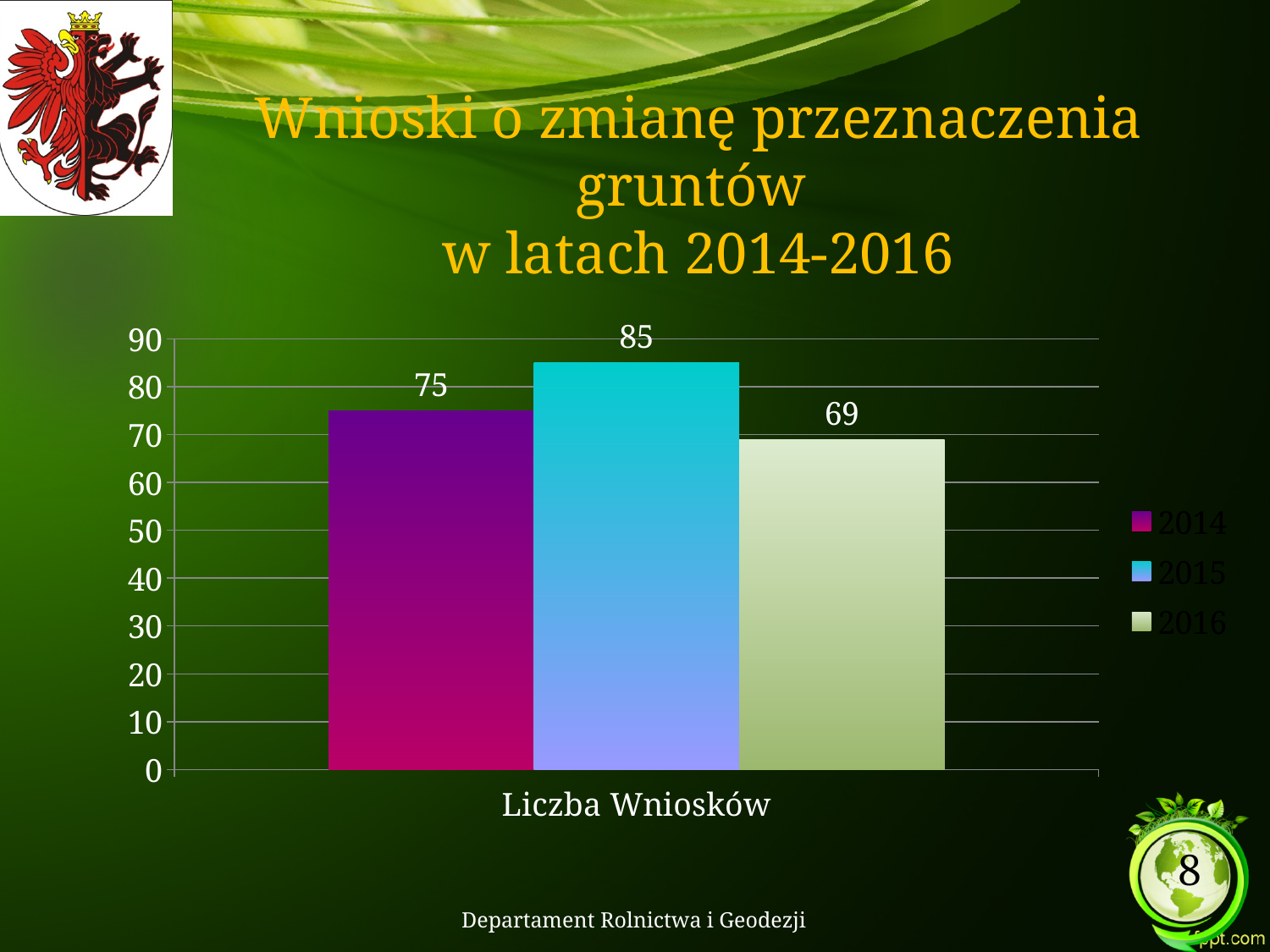
What is the difference between the values for 2014 and 2016? 6 Is the value for 2015 greater or less than 80? greater What is the value for 2015? 85 Which year has the lowest value? 2016 How many series does the legend list? 3 What is the difference between the values for 2015 and 2014? 10 Which year has the highest value? 2015 What is the label shown below the bars on the x axis? Liczba Wniosków What kind of chart is shown on the slide? bar chart What is the value for 2016? 69 Which is larger, the value for 2014 or the value for 2016? 2014 What is the value for 2014? 75